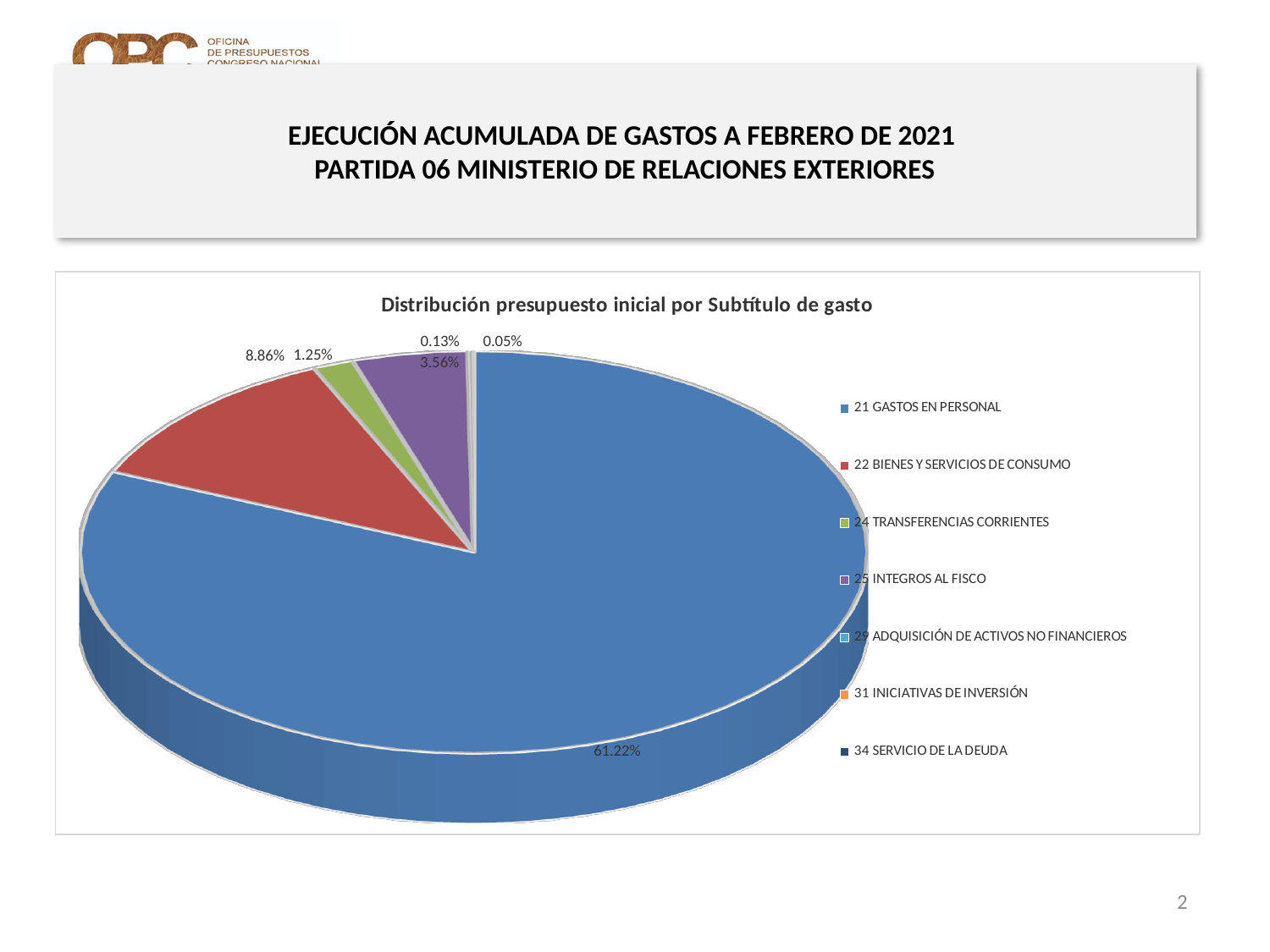
How many entries does the chart legend list? 7 What share of the pie does 24 TRANSFERENCIAS CORRIENTES represent? 1.25% What share of the pie does 25 INTEGROS AL FISCO represent? 3.56% What share of the pie does 21 GASTOS EN PERSONAL represent? 61.22% Which is larger, the share for 22 BIENES Y SERVICIOS DE CONSUMO or for 25 INTEGROS AL FISCO? 22 BIENES Y SERVICIOS DE CONSUMO What is the difference between the shares of 25 INTEGROS AL FISCO and 24 TRANSFERENCIAS CORRIENTES? 2.31% Which category has the largest slice of the pie? 21 GASTOS EN PERSONAL What is the smallest percentage label shown on the pie? 0.05% What is the difference between the shares of 21 GASTOS EN PERSONAL and 22 BIENES Y SERVICIOS DE CONSUMO? 52.36% What kind of chart is shown on the slide? pie chart What is the title of the chart? Distribución presupuesto inicial por Subtítulo de gasto